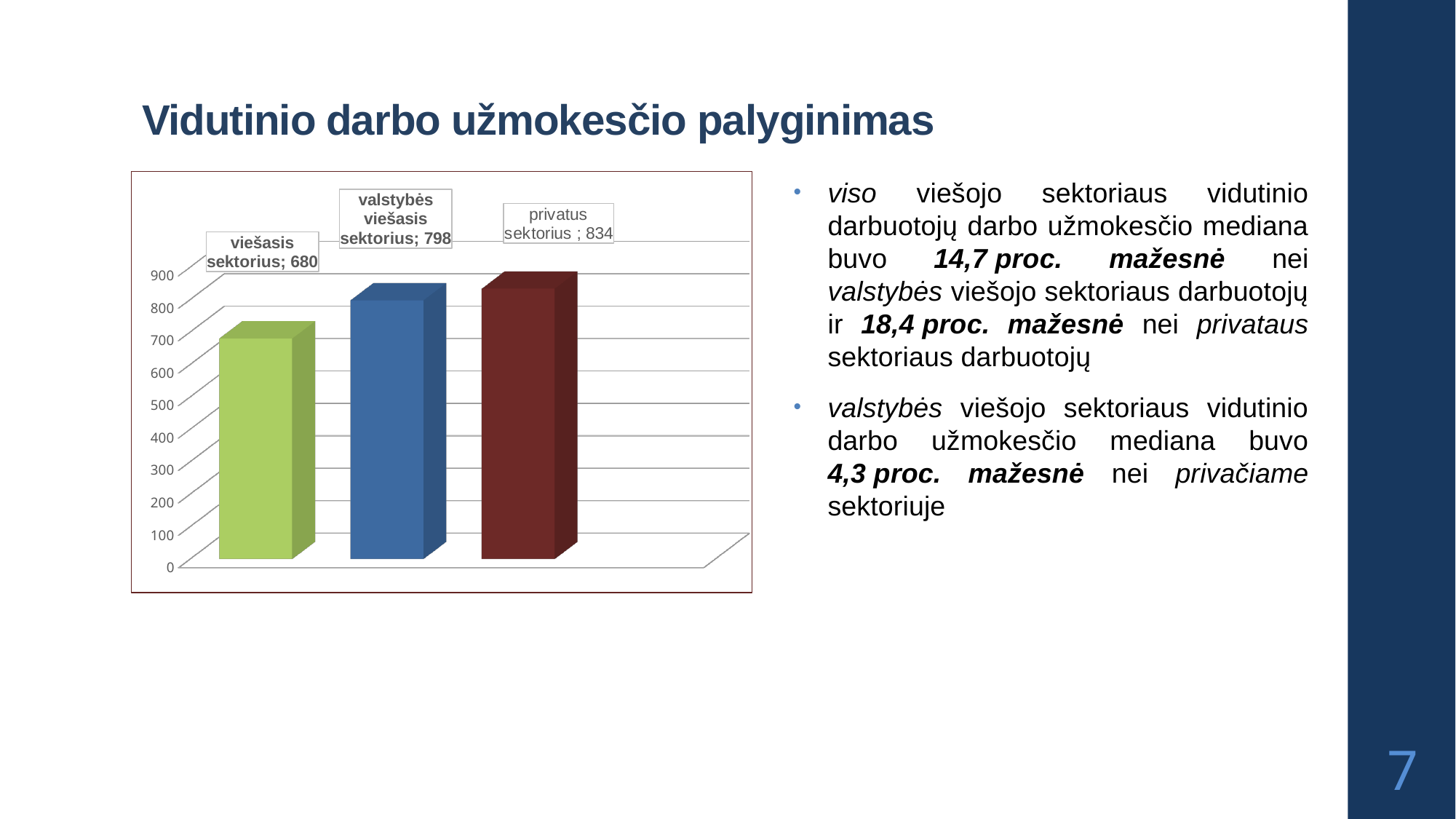
Is the value for viešasis sektorius greater or less than 700? less How many bars are shown in the chart? 3 Which category has the lowest value? viešasis sektorius Which category has the highest value? privatus sektorius What kind of chart is shown on the slide? bar chart What is the value for valstybės viešasis sektorius? 798 What is the value for privatus sektorius? 834 What is the value for viešasis sektorius? 680 Which is larger, the value for valstybės viešasis sektorius or the value for privatus sektorius? privatus sektorius What is the difference between the values for valstybės viešasis sektorius and viešasis sektorius? 118 What is the difference between the values for privatus sektorius and viešasis sektorius? 154 What colour is the bar for privatus sektorius? dark red